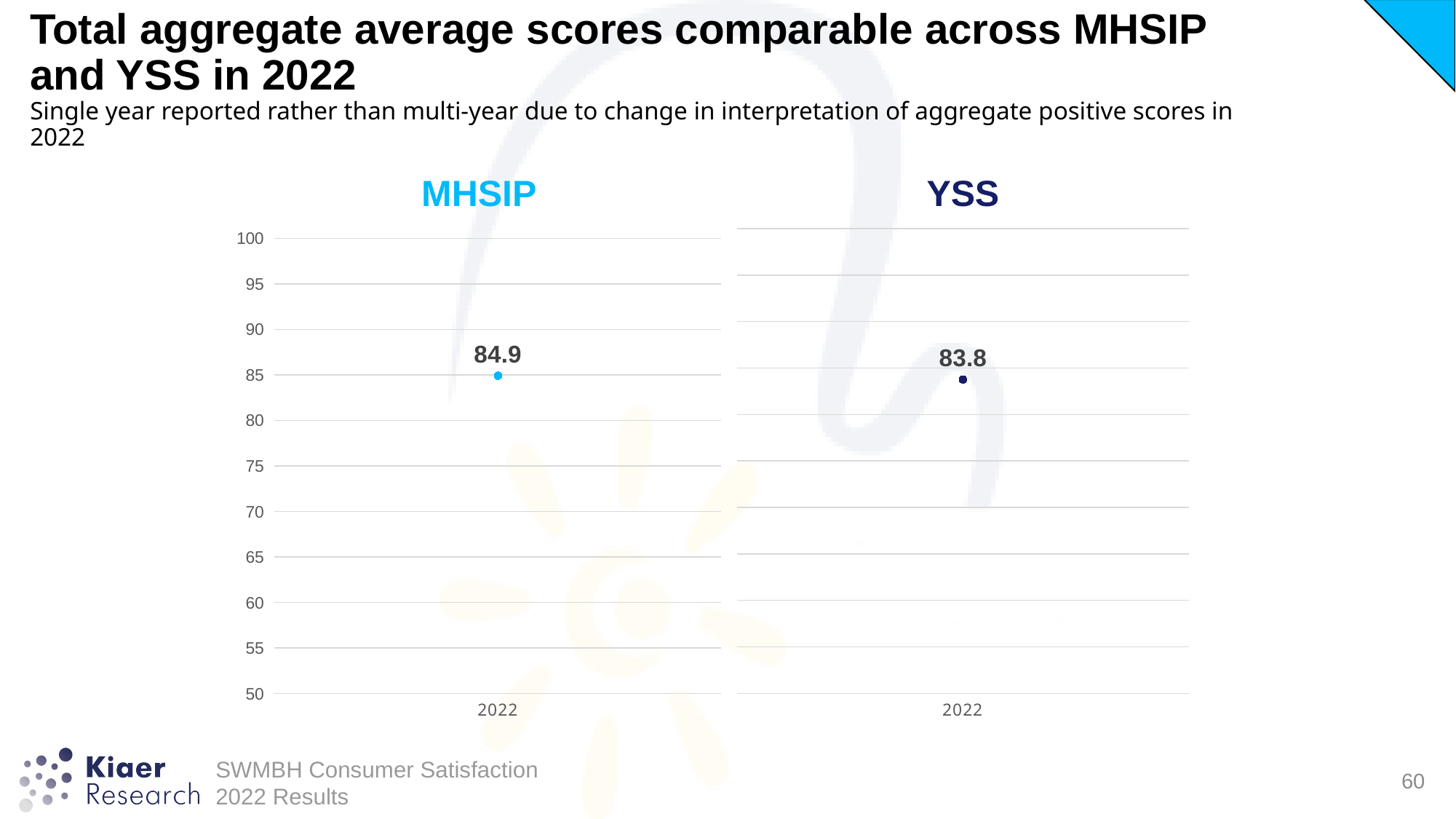
How many data points are plotted in the MHSIP chart? 1 In the YSS chart, what is the total aggregate average score for 2022? 83.8 Which chart shows the higher 2022 score, MHSIP or YSS? MHSIP How many data points are plotted in the YSS chart? 1 What is the lowest value shown on the y axis of the MHSIP chart? 50 What is the difference between the MHSIP 2022 score and the YSS 2022 score? 1.1 Which year is shown on the x axis of the YSS chart? 2022 In the MHSIP chart, is the 2022 value greater or less than 80? greater In the MHSIP chart, is the 2022 value greater or less than 90? less In the YSS chart, is the 2022 value greater or less than 85? less In the MHSIP chart, what is the total aggregate average score for 2022? 84.9